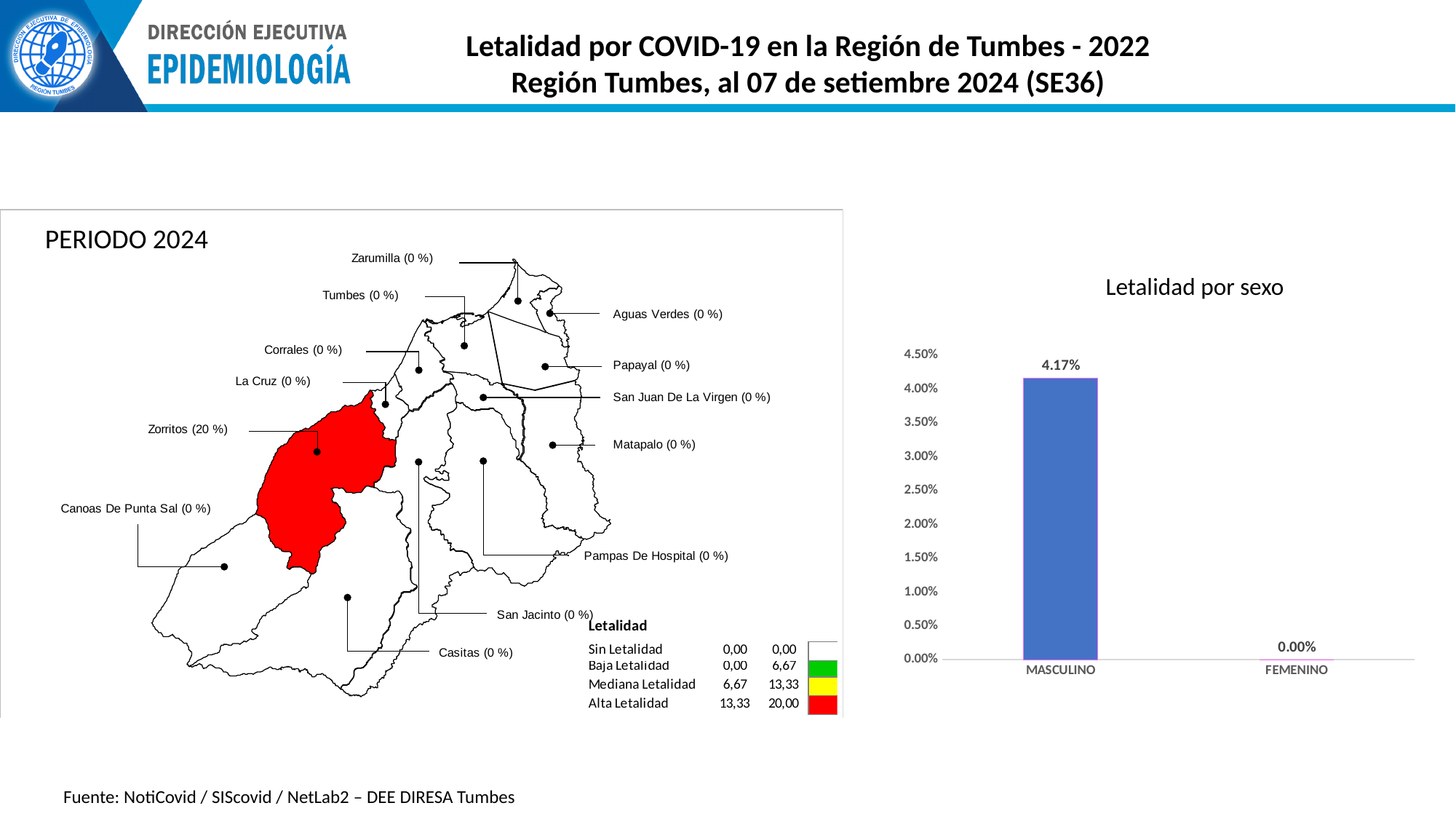
In the 'Letalidad por sexo' chart, which is larger, the value for MASCULINO or for FEMENINO? MASCULINO In the 'Letalidad por sexo' chart, is the value for MASCULINO greater or less than 4.00%? greater What is the highest tick value shown on the y axis of the 'Letalidad por sexo' chart? 4.50% In the 'Letalidad por sexo' chart, which category has the lowest value? FEMENINO On the map 'PERIODO 2024', what lethality value is labelled for Zorritos? 20 % In the 'Letalidad por sexo' chart, which category has the highest value? MASCULINO What kind of chart is 'Letalidad por sexo'? bar chart How many categories are shown on the x axis of the 'Letalidad por sexo' chart? 2 In the 'Letalidad por sexo' chart, what is the difference between the MASCULINO and FEMENINO values? 4.17% In the 'Letalidad por sexo' chart, what is the value for FEMENINO? 0.00% What is the title of the chart on the right side of the slide? Letalidad por sexo In the 'Letalidad por sexo' chart, what is the value for MASCULINO? 4.17%